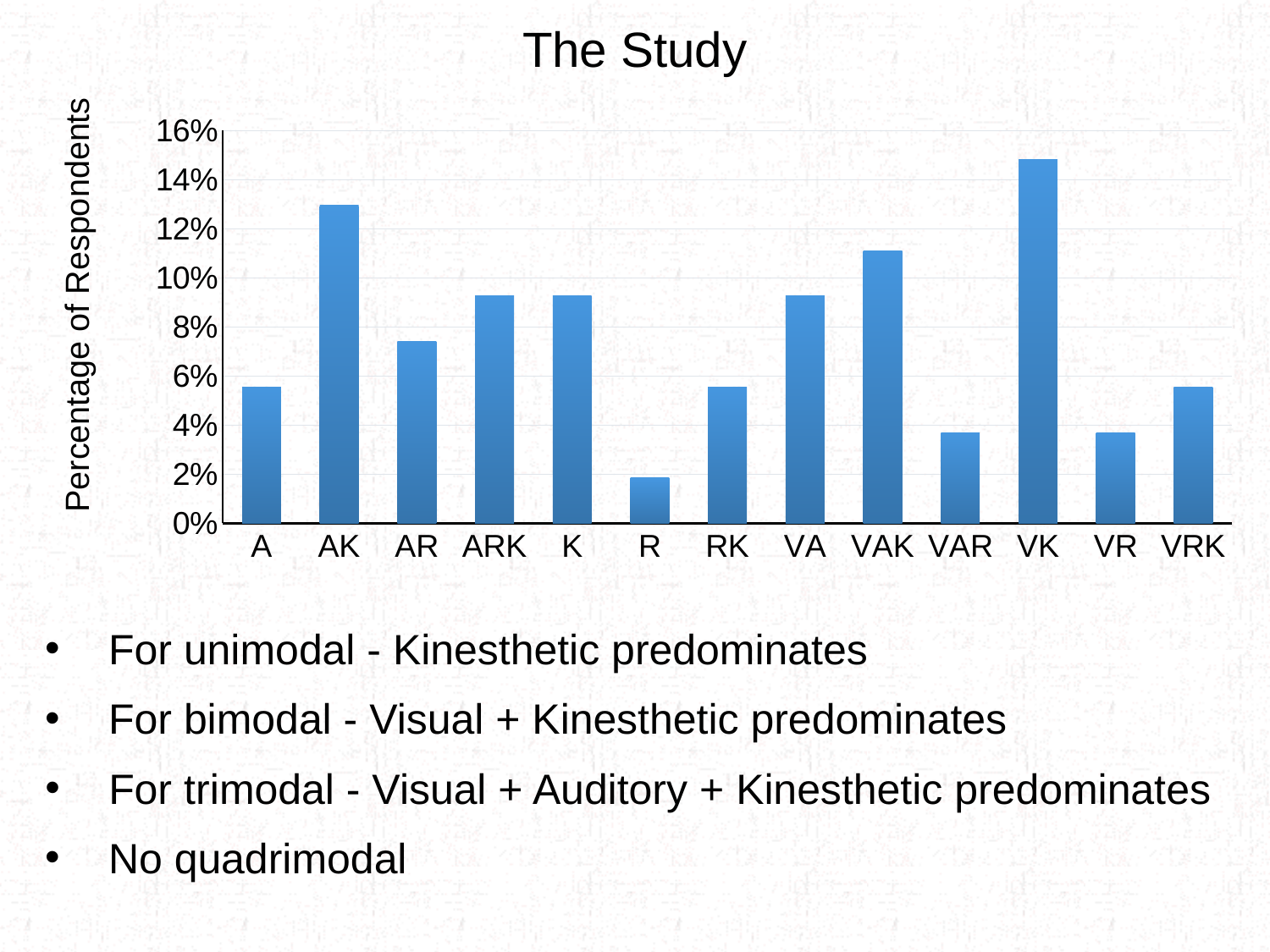
Which has a higher percentage of respondents, A or R? A Is the value for AR greater or less than 8%? less Is the value for R greater or less than 4%? less What kind of chart is shown on the slide? bar chart Which category has the highest percentage of respondents? VK Which has a higher percentage of respondents, AK or VAK? AK Which category has the lowest percentage of respondents? R Is the value for AK greater or less than 12%? greater What is the label on the vertical axis of the chart? Percentage of Respondents Which has a higher percentage of respondents, VK or AK? VK How many categories are shown on the x axis of the chart? 13